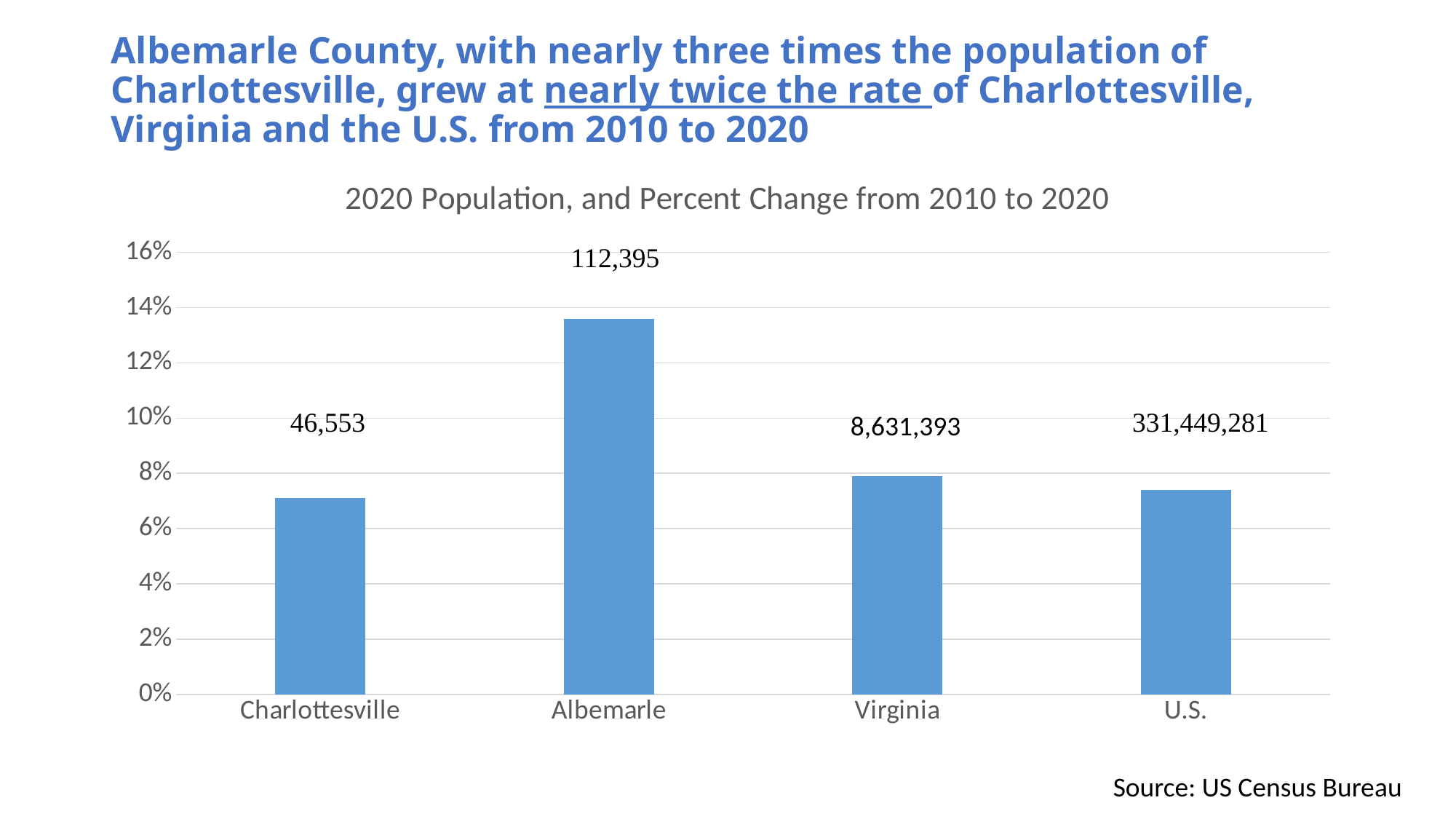
Is the percent change for the U.S. greater or less than 8%? less What 2020 population is labeled above the Albemarle bar? 112,395 How many categories are shown on the x axis of the chart? 4 What is the difference between the labeled 2020 populations of Albemarle and Charlottesville? 65,842 What 2020 population is labeled above the U.S. bar? 331,449,281 Is the percent change for Albemarle greater or less than 12%? greater Which category has the highest percent change from 2010 to 2020 (tallest bar)? Albemarle What is the chart's title? 2020 Population, and Percent Change from 2010 to 2020 What 2020 population is labeled above the Charlottesville bar? 46,553 Which category has the smallest labeled 2020 population? Charlottesville What 2020 population is labeled above the Virginia bar? 8,631,393 What type of chart is shown on the slide? bar chart